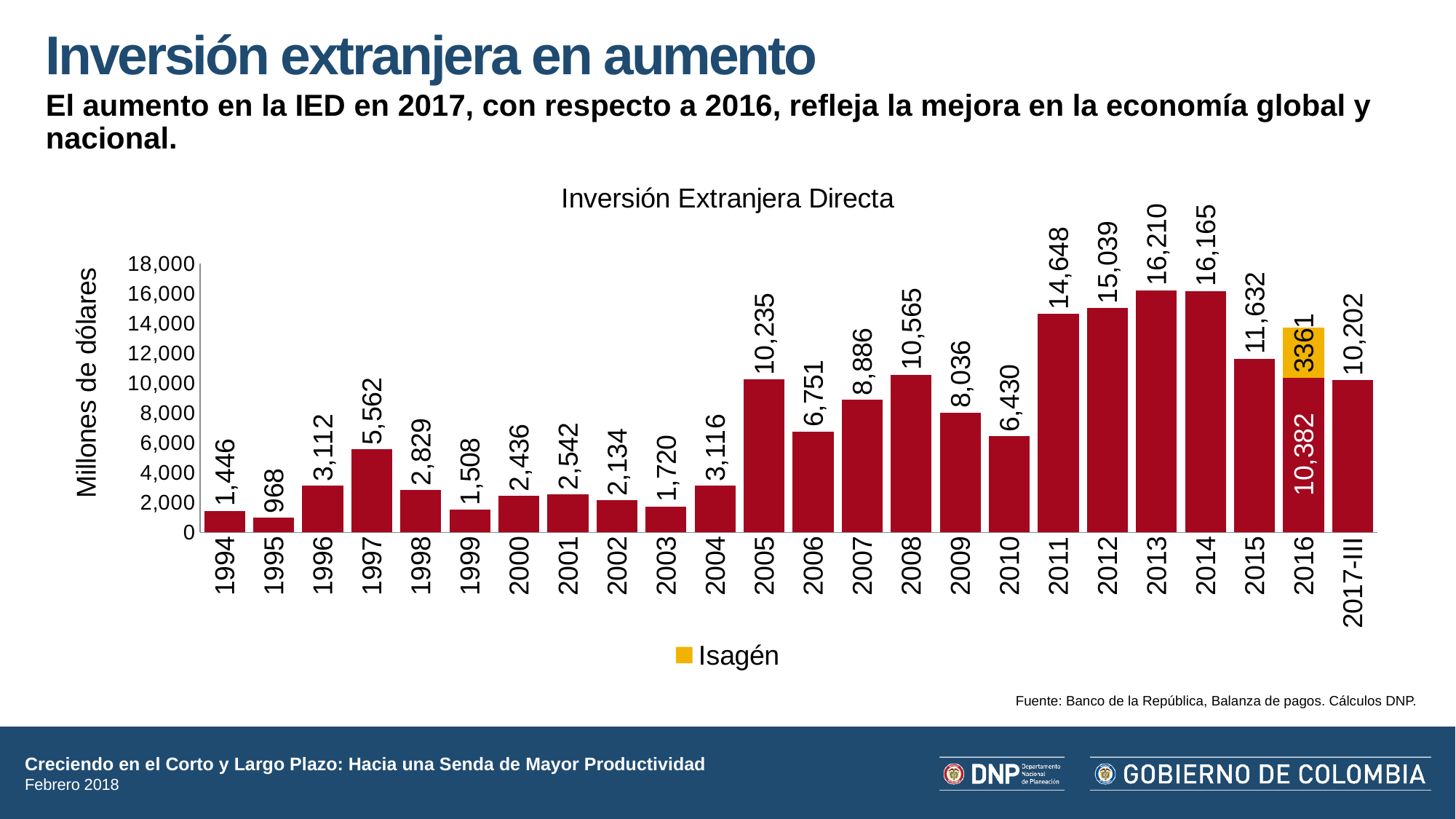
In the chart 'Inversión Extranjera Directa', what is the label on the y axis? Millones de dólares In the chart 'Inversión Extranjera Directa', what is the total of the stacked bar for 2016 (10,382 plus the Isagén portion of 3361)? 13,743 In the chart 'Inversión Extranjera Directa', which year has the lowest value? 1995 In the chart 'Inversión Extranjera Directa', what is the value for 1995? 968 In the chart 'Inversión Extranjera Directa', which is larger, the value for 2008 or the value for 2005? 2008 In the chart 'Inversión Extranjera Directa', which year has the highest value? 2013 In the chart 'Inversión Extranjera Directa', what is the difference between the values for 2014 and 2015? 4,533 In the chart 'Inversión Extranjera Directa', is the value for 2012 greater or less than 14,000? greater What kind of chart is 'Inversión Extranjera Directa'? bar chart How many years (categories) are shown on the x axis of the chart 'Inversión Extranjera Directa'? 24 In the chart 'Inversión Extranjera Directa', what is the value for 2017-III? 10,202 In the chart 'Inversión Extranjera Directa', what is the value for 2013? 16,210